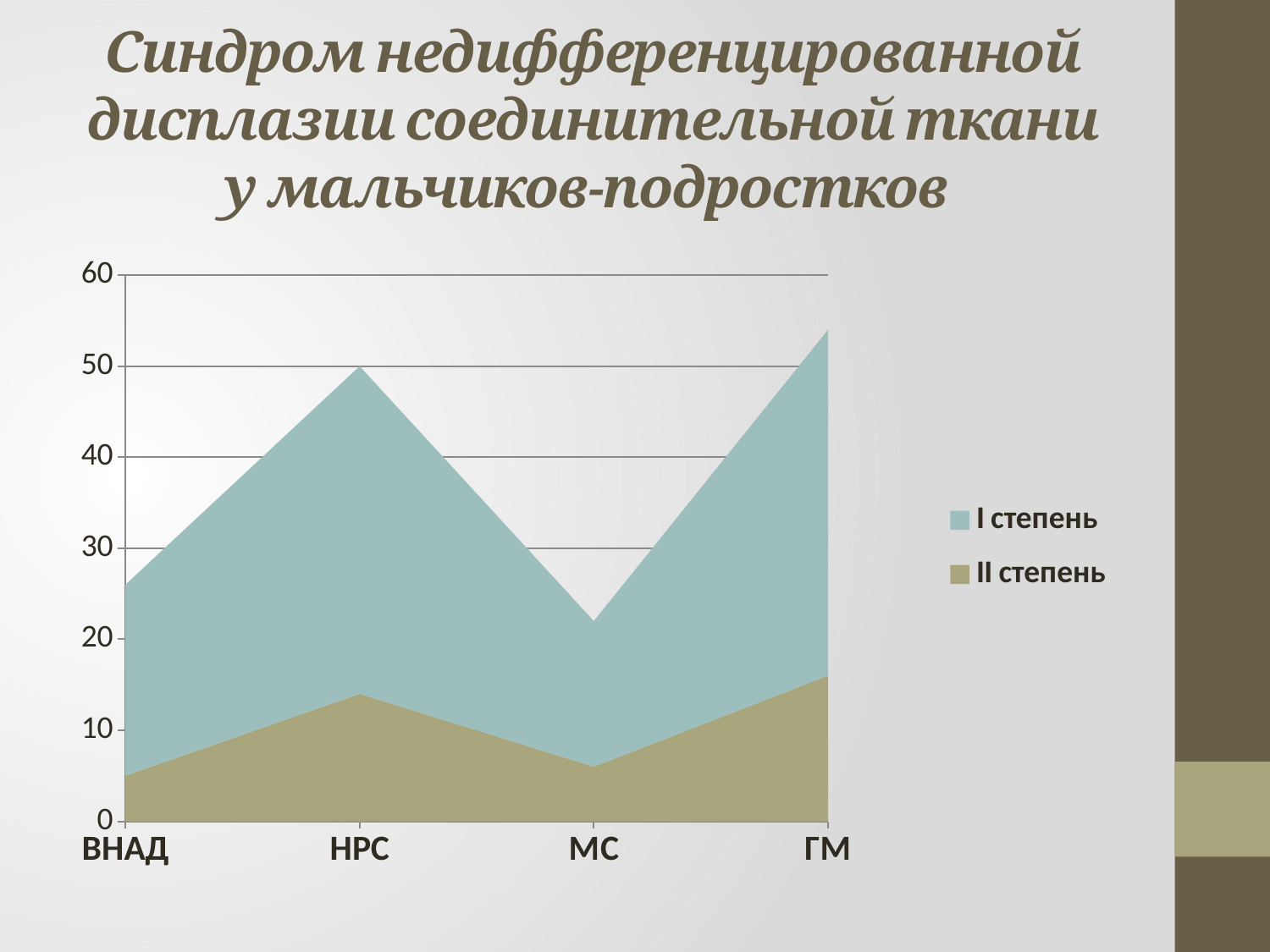
Is the value for I степень at ГМ greater or less than 50? less Which category has the highest value for I степень? ГМ Is the value for II степень at НРС greater or less than 10? greater Which is larger for I степень: the value at НРС or the value at МС? НРС What are the two series named in the legend? I степень and II степень How many categories are shown on the x axis? 4 What kind of chart is shown on the slide? Area chart Which category has the highest value for II степень? ГМ Is the value for I степень at ВНАД greater or less than 30? less Does the value for I степень rise or fall from НРС to МС? fall How many series does the legend list? 2 Which category has the lowest value for I степень? МС